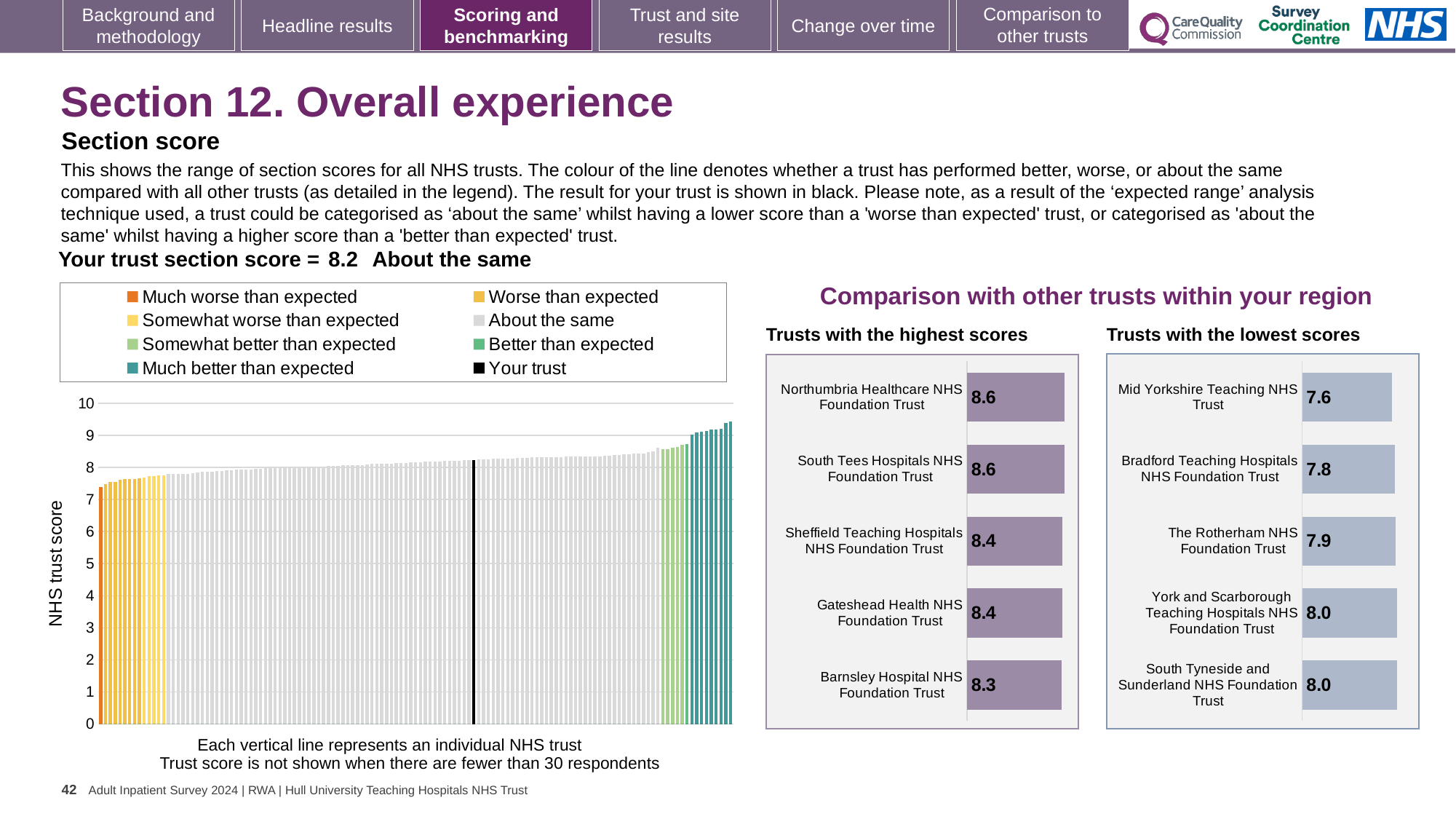
In the large chart on the left showing NHS trust scores, is the value of the lowest bar greater or less than 7? greater How many trusts are listed in the 'Trusts with the highest scores' chart? 5 In the large chart on the left showing NHS trust scores, what is the section score for your trust (the black bar)? 8.2 In the 'Trusts with the highest scores' chart, what is the score for Barnsley Hospital NHS Foundation Trust? 8.3 What kind of chart is the large chart on the left showing NHS trust scores? Bar chart How many entries does the legend of the large chart on the left list? 8 In the 'Trusts with the lowest scores' chart, what is the difference between the scores of Bradford Teaching Hospitals NHS Foundation Trust and Mid Yorkshire Teaching NHS Trust? 0.2 In the 'Trusts with the lowest scores' chart, which has the higher score: The Rotherham NHS Foundation Trust or Bradford Teaching Hospitals NHS Foundation Trust? The Rotherham NHS Foundation Trust In the 'Trusts with the highest scores' chart, what is the difference between the scores of Northumbria Healthcare NHS Foundation Trust and Barnsley Hospital NHS Foundation Trust? 0.3 In the 'Trusts with the highest scores' chart, what is the score for Northumbria Healthcare NHS Foundation Trust? 8.6 In the 'Trusts with the lowest scores' chart, which trust has the lowest score? Mid Yorkshire Teaching NHS Trust In the 'Trusts with the lowest scores' chart, what is the score for Bradford Teaching Hospitals NHS Foundation Trust? 7.8